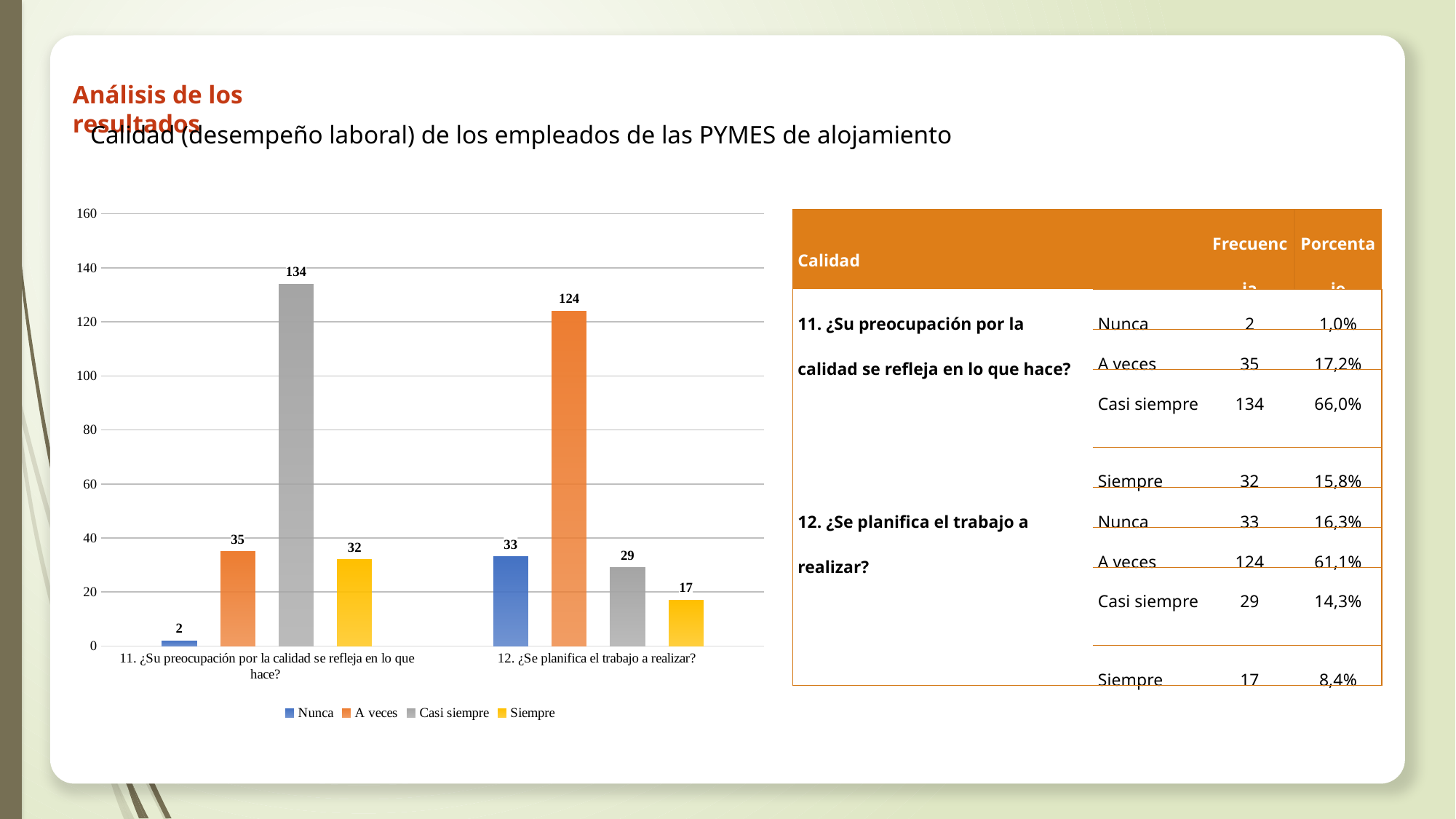
Is the value for 'Casi siempre' in question 11 greater or less than 120? greater Which is larger: the 'Nunca' value for question 12 or the 'Siempre' value for question 11? Nunca for question 12 What is the value for 'Siempre' in the category '12. ¿Se planifica el trabajo a realizar?'? 17 What is the value for 'Casi siempre' in the category '11. ¿Su preocupación por la calidad se refleja en lo que hace?'? 134 What kind of chart is shown on the slide? Bar chart How many categories are shown on the x axis of the chart? 2 What is the value for 'A veces' in the category '12. ¿Se planifica el trabajo a realizar?'? 124 How many series does the legend list? 4 What is the value for 'Nunca' in the category '11. ¿Su preocupación por la calidad se refleja en lo que hace?'? 2 Which series has the lowest value in the category '11. ¿Su preocupación por la calidad se refleja en lo que hace?'? Nunca What is the difference between the 'Casi siempre' value for question 11 and the 'A veces' value for question 12? 10 Which series has the highest value in the category '12. ¿Se planifica el trabajo a realizar?'? A veces